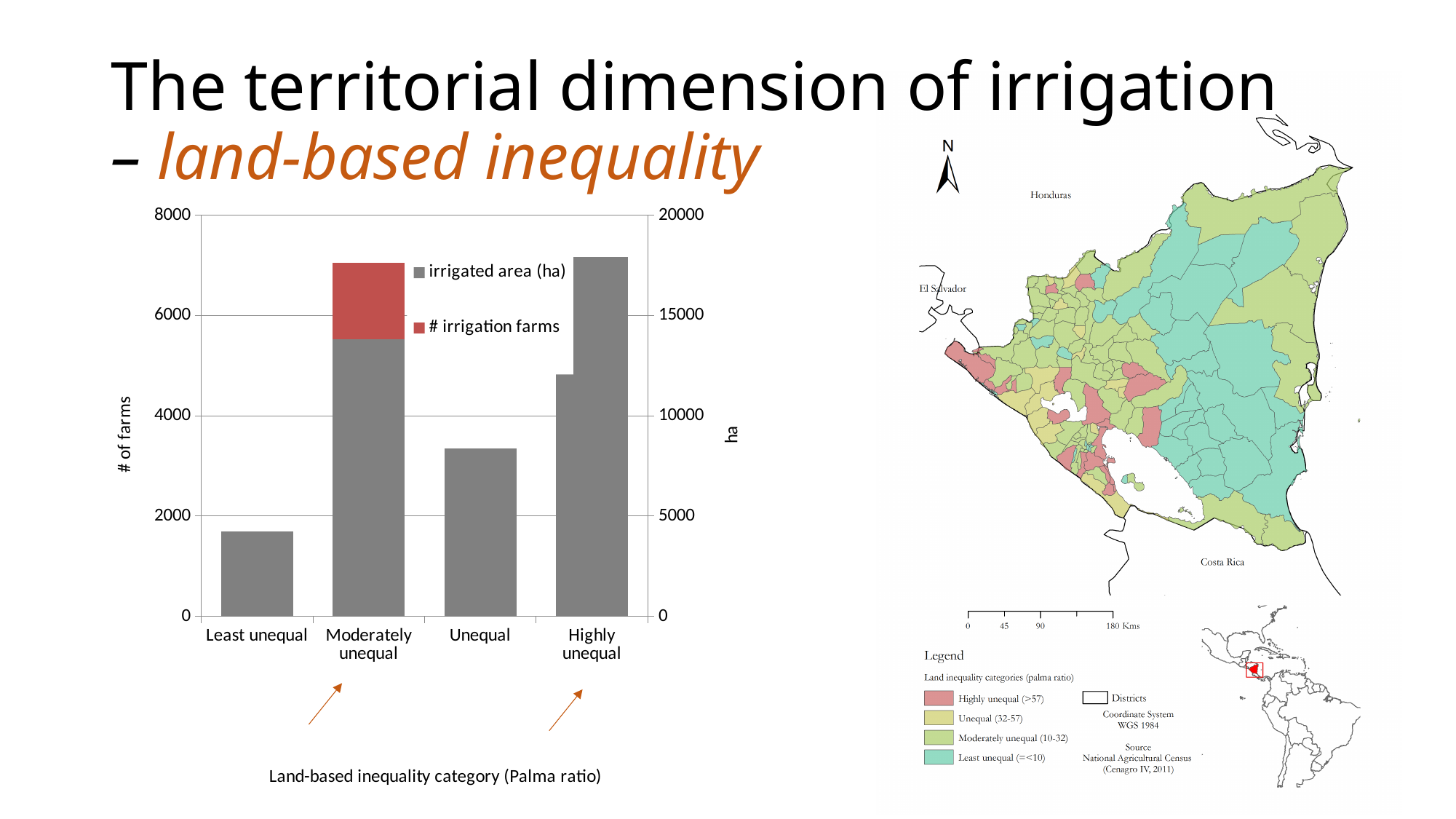
Reading against the left axis (# of farms), is the grey bar for Unequal greater or less than 4000? less Reading against the left axis (# of farms), is the grey bar for Least unequal greater or less than 2000? less What kind of chart is shown on the left of the slide? bar chart How many land-based inequality categories are shown on the x axis of the bar chart? 4 Which has the taller grey bar in the bar chart, Least unequal or Unequal? Unequal What are the two series named in the legend of the bar chart? irrigated area (ha) and # irrigation farms Reading against the left axis (# of farms), is the grey bar for Unequal greater or less than 2000? greater How many series does the legend of the bar chart list? 2 Which category has the shortest bar in the bar chart? Least unequal What is the x-axis title of the bar chart? Land-based inequality category (Palma ratio)